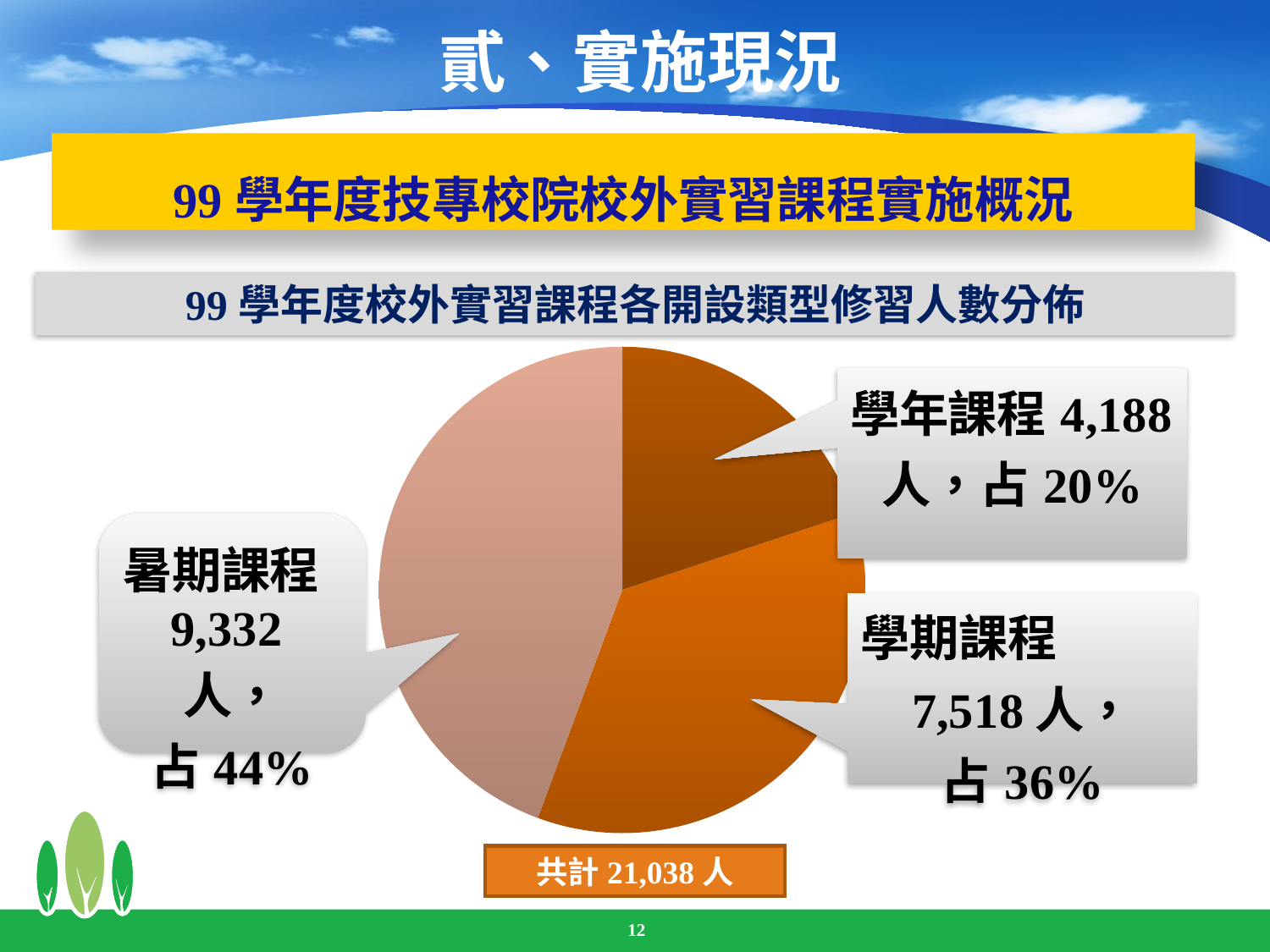
What is the total number of people shown for the pie chart? 21,038 人 How many people are in the 暑期課程 slice? 9,332 人 What kind of chart is shown on the slide? pie chart What share of the pie does 學年課程 take? 20% Which category has the smallest number of people? 學年課程 What is the difference in people between 暑期課程 and 學期課程? 1,814 人 How many people are in the 學年課程 slice? 4,188 人 How many slices does the pie chart have? 3 Which has more people, 學期課程 or 學年課程? 學期課程 Which category has the largest number of people? 暑期課程 How many people are in the 學期課程 slice? 7,518 人 What share of the pie does 暑期課程 take? 44%